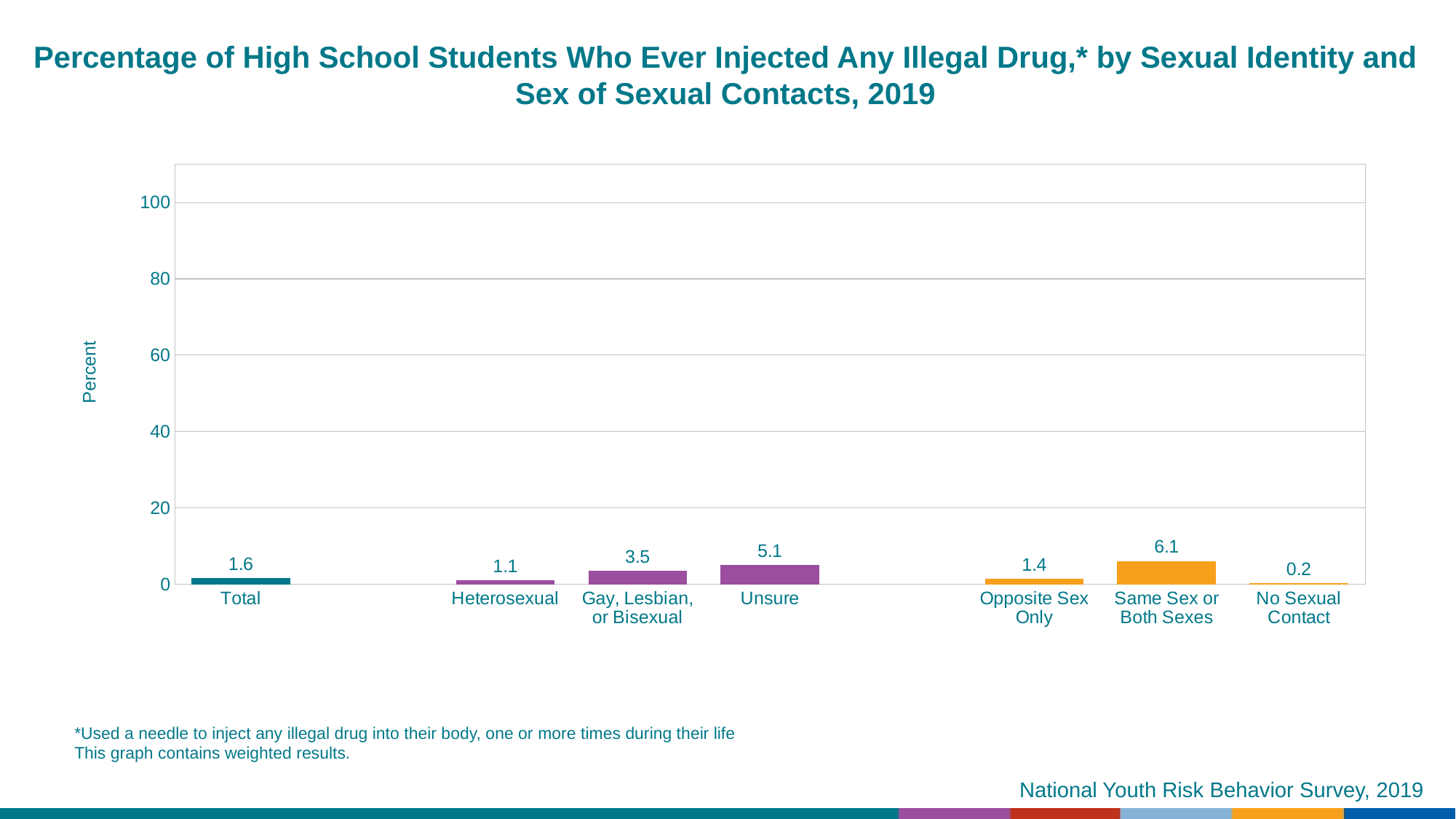
What is the value for Total? 1.6 What is the difference between the values for Unsure and Heterosexual? 4.0 Which category has the highest value? Same Sex or Both Sexes What is the value for Same Sex or Both Sexes? 6.1 Which category has the lowest value? No Sexual Contact What kind of chart is this? bar chart Which is larger, the value for Opposite Sex Only or the value for No Sexual Contact? Opposite Sex Only Is the value for Same Sex or Both Sexes greater or less than 20? less What is the value for students who are Unsure? 5.1 What is the value for Heterosexual students? 1.1 What is the value for Gay, Lesbian, or Bisexual students? 3.5 How many categories are shown on the x axis? 7